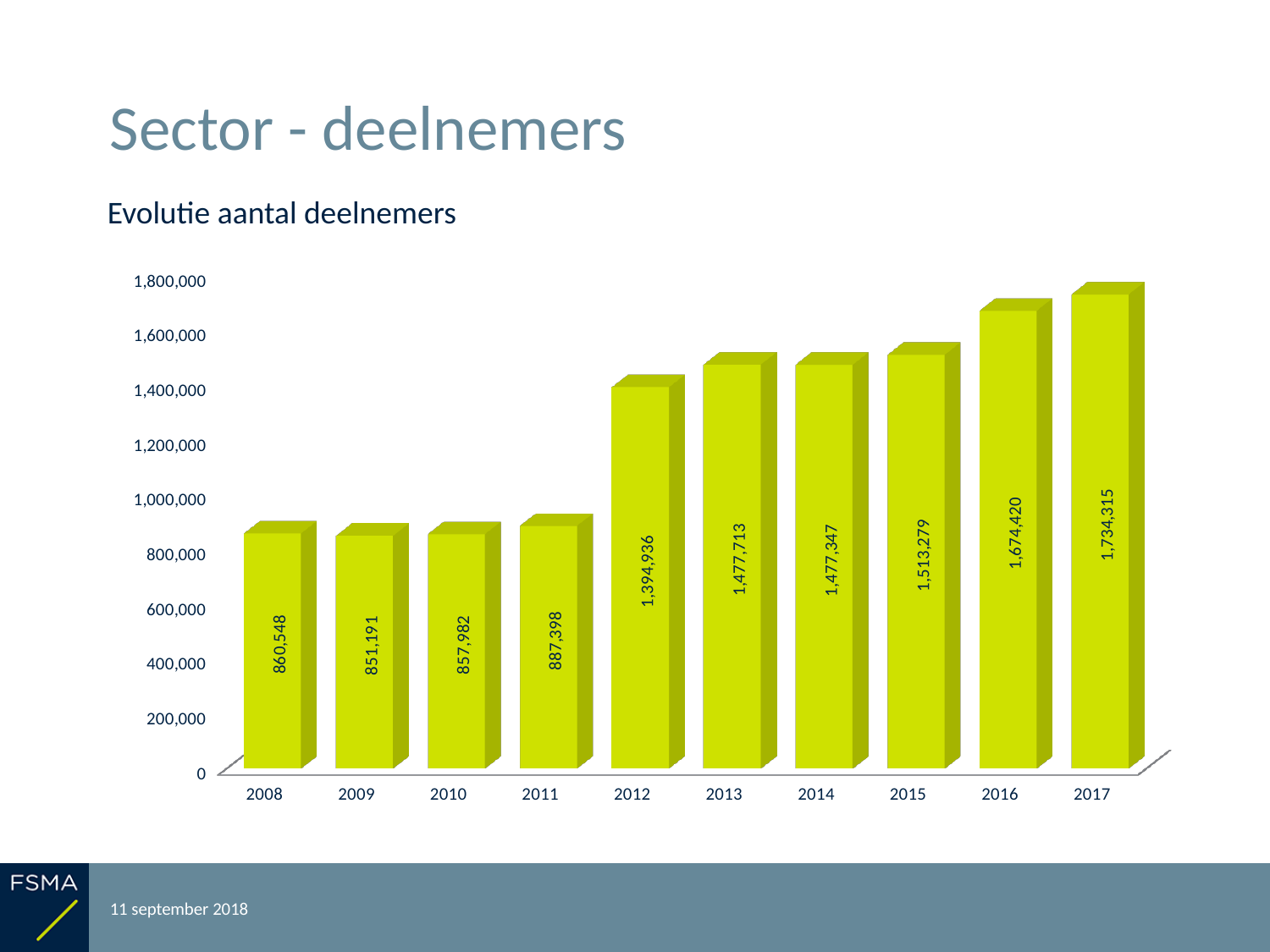
Which year has the highest value? 2017 What is the value for 2012? 1,394,936 What is the difference between the values for 2017 and 2016? 59,895 Is the value for 2012 greater or less than 1,200,000? greater What is the value for 2017? 1,734,315 How many years are shown on the x axis? 10 Which is larger, the value for 2015 or the value for 2012? 2015 What kind of chart is shown on the slide? bar chart What is the difference between the values for 2012 and 2011? 507,538 Which year has the lowest value? 2009 Do the values generally rise or fall from 2008 to 2017? rise What is the value for 2008? 860,548